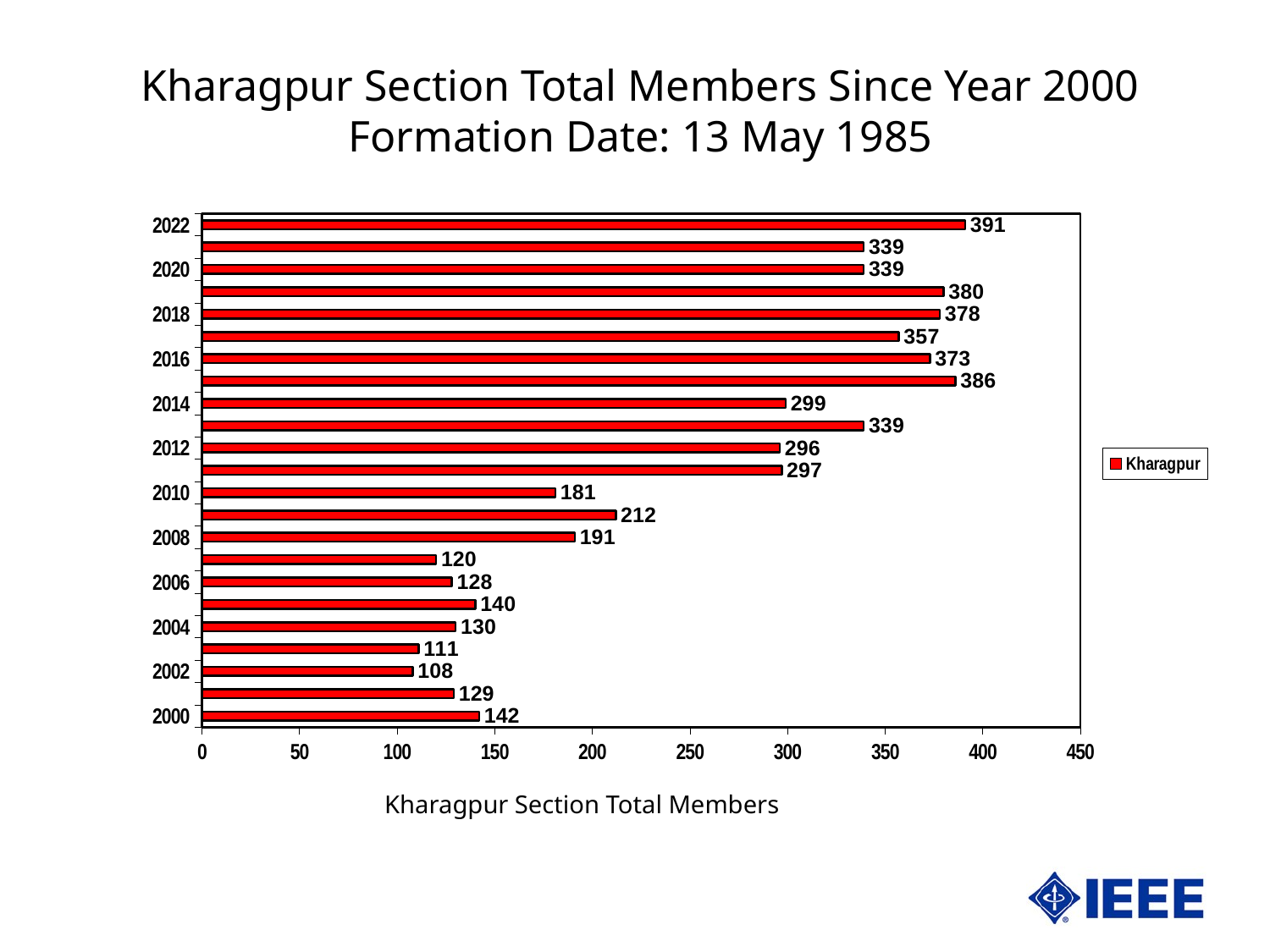
How many series does the legend list? 1 Which year has the highest value? 2022 Which year has the lowest value? 2002 What is the difference between the values for 2022 and 2000? 249 What is the value for 2022? 391 What is the value for 2008? 191 What series name is shown in the legend? Kharagpur How many bars are plotted in the chart? 23 What is the value for 2012? 296 What is the value for 2000? 142 Which is larger, the value for 2016 or the value for 2018? 2018 What kind of chart is shown? bar chart